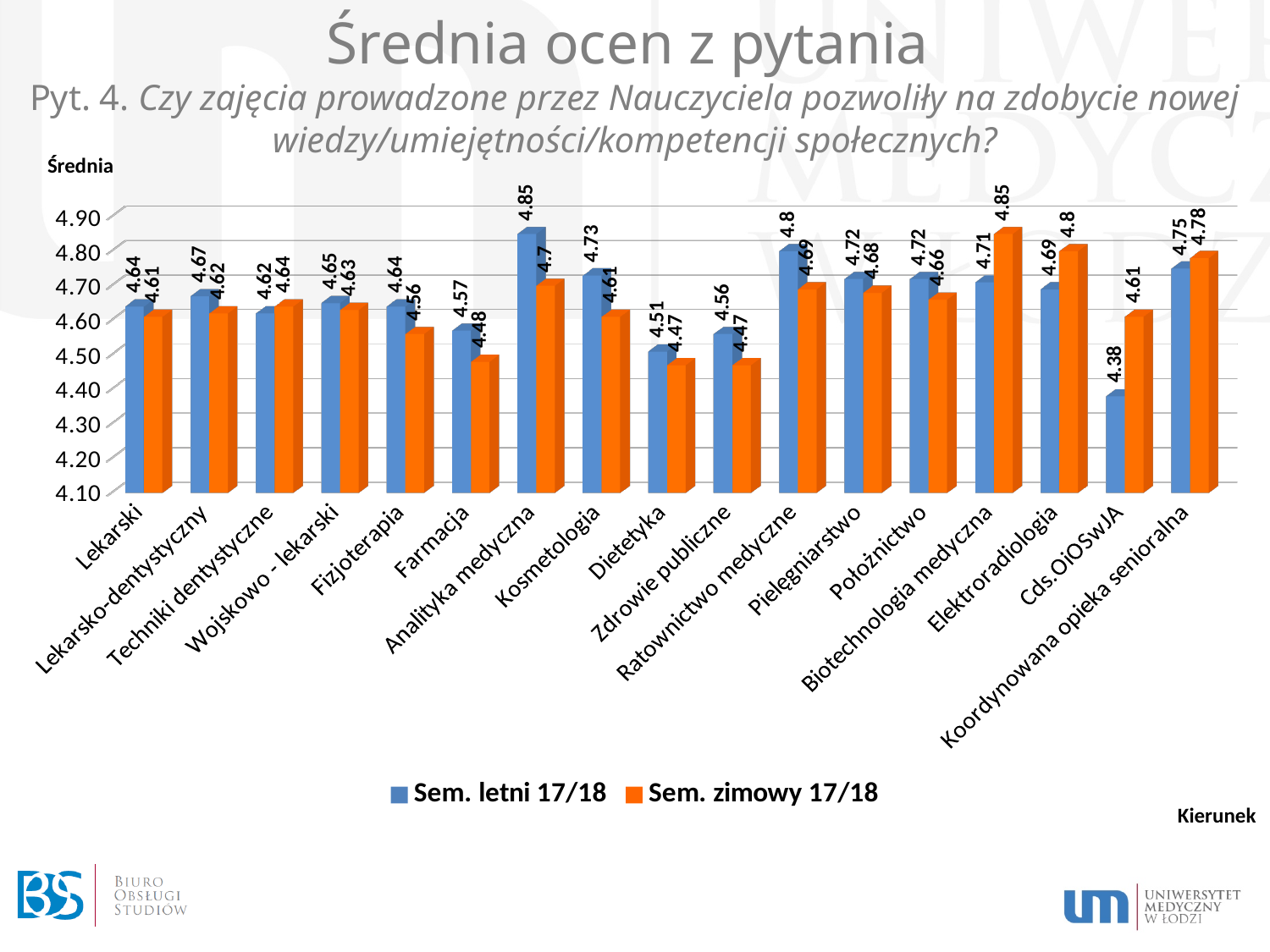
How many series does the legend list? 2 What is the difference between the Sem. zimowy 17/18 and Sem. letni 17/18 values for Cds.OiOSwJA? 0.23 What is the Sem. zimowy 17/18 value for Cds.OiOSwJA? 4.61 What is the Sem. zimowy 17/18 value for Farmacja? 4.48 Which kierunek has the highest Sem. zimowy 17/18 value? Biotechnologia medyczna How many kierunek categories are shown on the x axis? 17 What kind of chart is shown on the slide? Bar chart Which kierunek has the lowest Sem. letni 17/18 value? Cds.OiOSwJA Which is larger for Elektroradiologia: the Sem. letni 17/18 value or the Sem. zimowy 17/18 value? Sem. zimowy 17/18 Which kierunek has the highest Sem. letni 17/18 value? Analityka medyczna Which is larger for Kosmetologia: the Sem. letni 17/18 value or the Sem. zimowy 17/18 value? Sem. letni 17/18 What is the Sem. letni 17/18 value for Analityka medyczna? 4.85